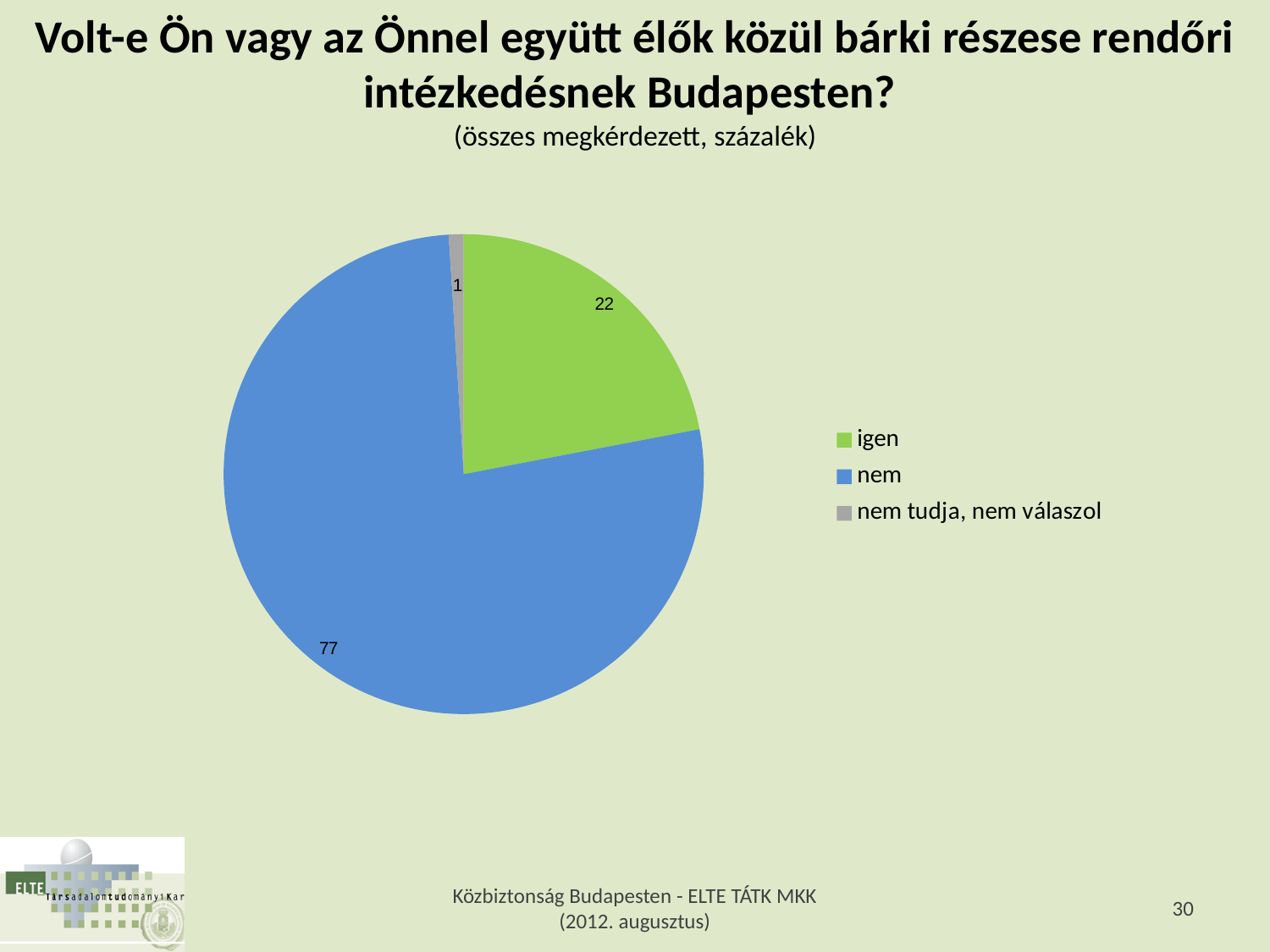
Which category has the smallest slice of the pie? nem tudja, nem válaszol What value is shown for the "igen" slice? 22 What value is shown for the "nem" slice? 77 What value is shown for the "nem tudja, nem válaszol" slice? 1 What is the total of the three values shown on the pie chart? 100 How many slices does the pie chart have? 3 Which is larger, the value for "igen" or the value for "nem tudja, nem válaszol"? igen What kind of chart is shown on the slide? pie chart What is the difference between the values for "nem" and "igen"? 55 Which category has the largest slice of the pie? nem How many entries does the legend list? 3 What colour is the "nem" slice? blue